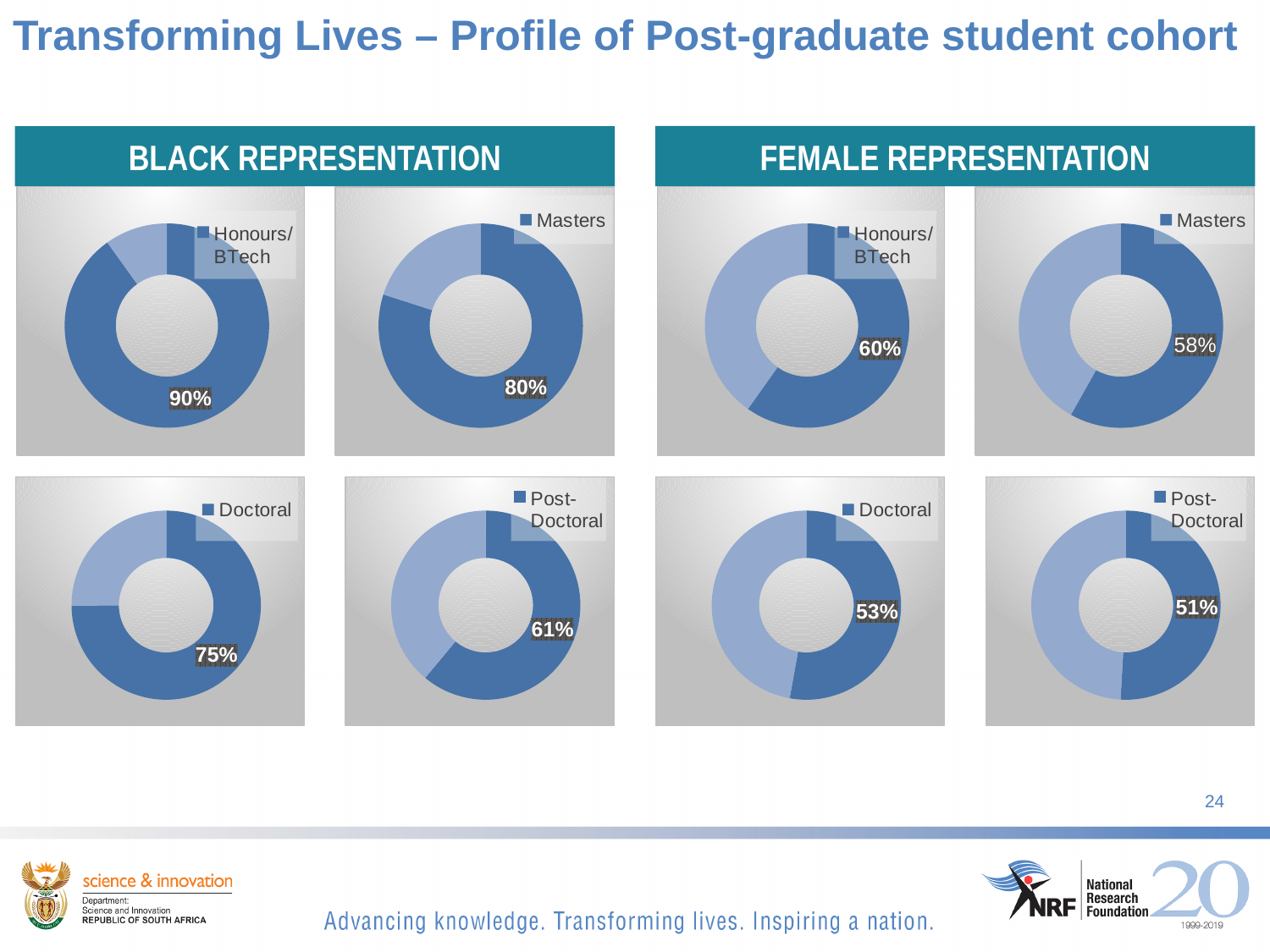
In the Black Representation section, what percentage is shown on the Honours/BTech doughnut chart? 90% In the Female Representation section, what percentage is shown on the Honours/BTech doughnut chart? 60% In the Female Representation section, what percentage is shown on the Post-Doctoral doughnut chart? 51% Across the Female Representation charts, which level has the lowest percentage? Post-Doctoral Across the Black Representation charts, which level has the highest percentage? Honours/BTech In the Female Representation section, what percentage is shown on the Doctoral doughnut chart? 53% What type of chart is used to show the representation percentages on this slide? Doughnut chart In the Black Representation section, what percentage is shown on the Doctoral doughnut chart? 75% In the Black Representation section, what percentage is shown on the Post-Doctoral doughnut chart? 61% In the Black Representation section, what percentage is shown on the Masters doughnut chart? 80% In the Female Representation section, what percentage is shown on the Masters doughnut chart? 58% What is the difference between the Black Representation percentage for Masters and the Female Representation percentage for Masters? 22%